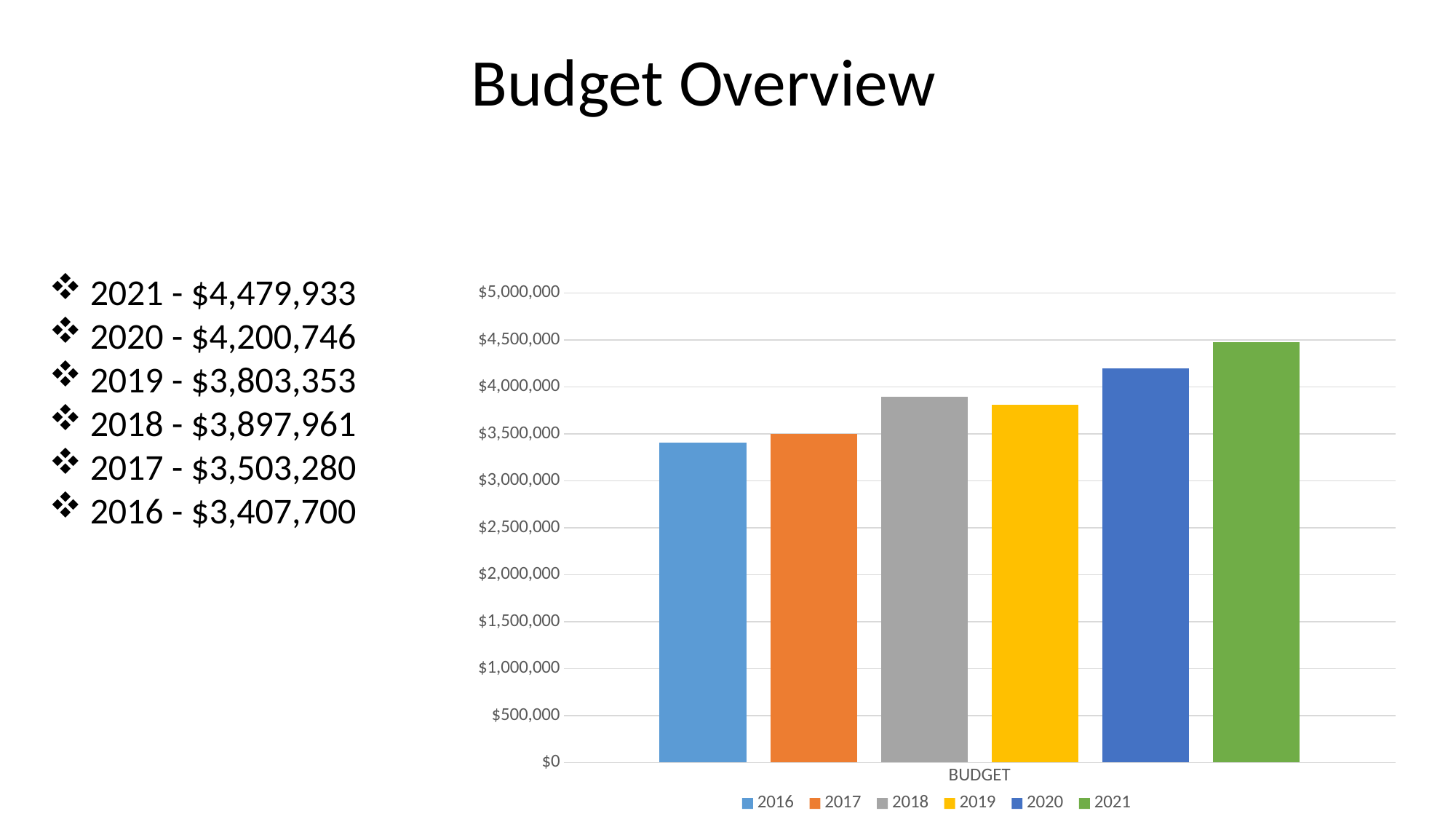
Which year has the highest budget in the chart? 2021 How many series does the chart legend list? 6 Which is larger, the budget for 2018 or the budget for 2019? 2018 What is the budget value for 2021? $4,479,933 What is the category label shown on the x axis of the chart? BUDGET Is the value for 2020 greater or less than $4,000,000? greater What type of chart is shown on the slide? bar chart What is the difference between the 2020 budget and the 2019 budget? $397,393 Is the value for 2016 greater or less than $3,500,000? less Which year has the lowest budget in the chart? 2016 What is the difference between the 2021 budget and the 2016 budget? $1,072,233 What is the budget value for 2017? $3,503,280